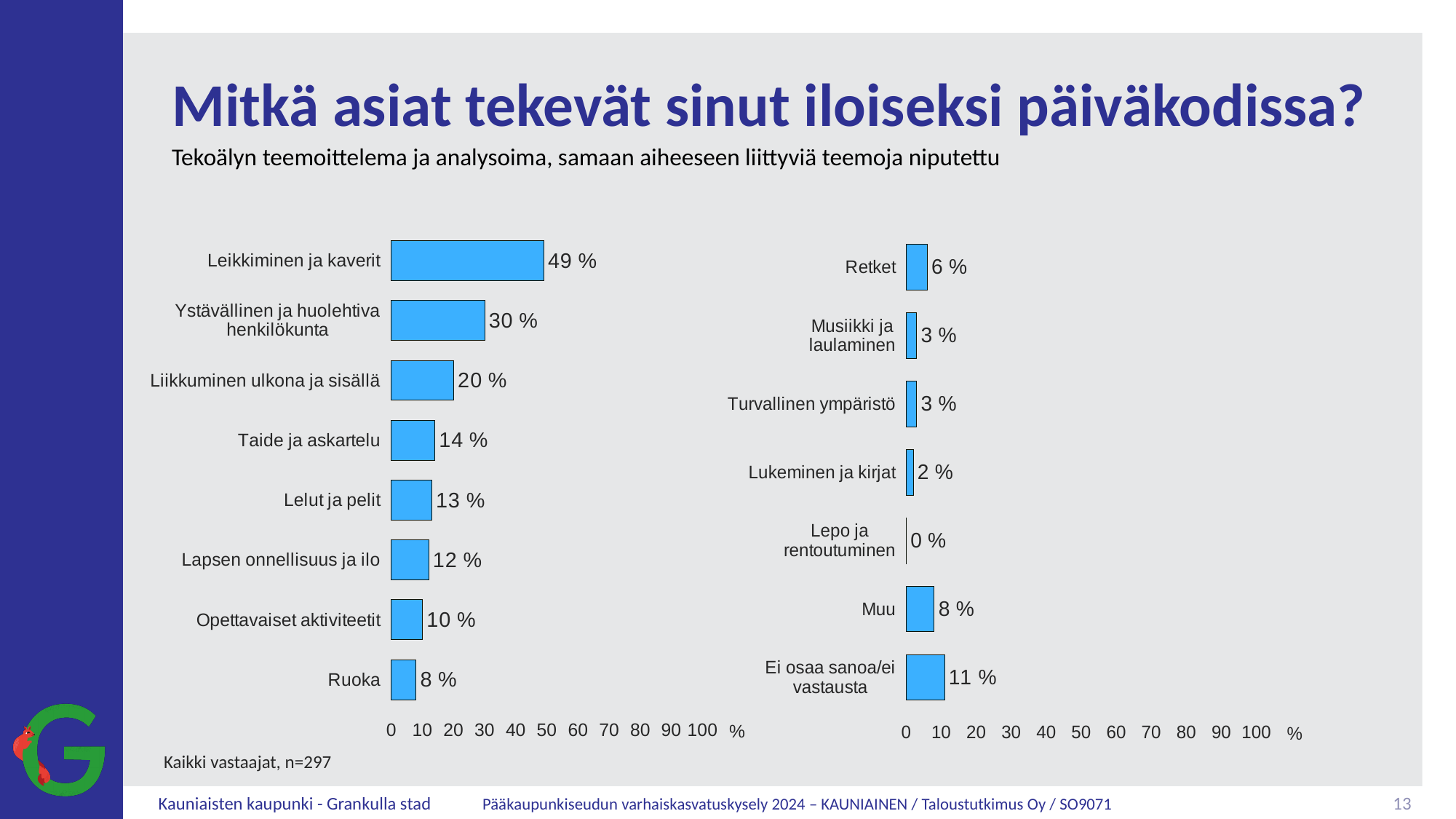
In the left chart, which category has the highest value? Leikkiminen ja kaverit In the right chart, what is the value for Retket? 6 % How many categories are shown in the left chart? 8 How many categories are shown in the right chart? 7 In the right chart, which category has the highest value? Ei osaa sanoa/ei vastausta In the left chart, what is the difference between Leikkiminen ja kaverit and Ystävällinen ja huolehtiva henkilökunta? 19 % What kind of chart is the left chart? Bar chart In the right chart, which is larger, Muu or Retket? Muu In the left chart, which category has the lowest value? Ruoka In the right chart, what is the value for Lepo ja rentoutuminen? 0 % In the left chart, what is the value for Liikkuminen ulkona ja sisällä? 20 % In the left chart, what is the value for Leikkiminen ja kaverit? 49 %